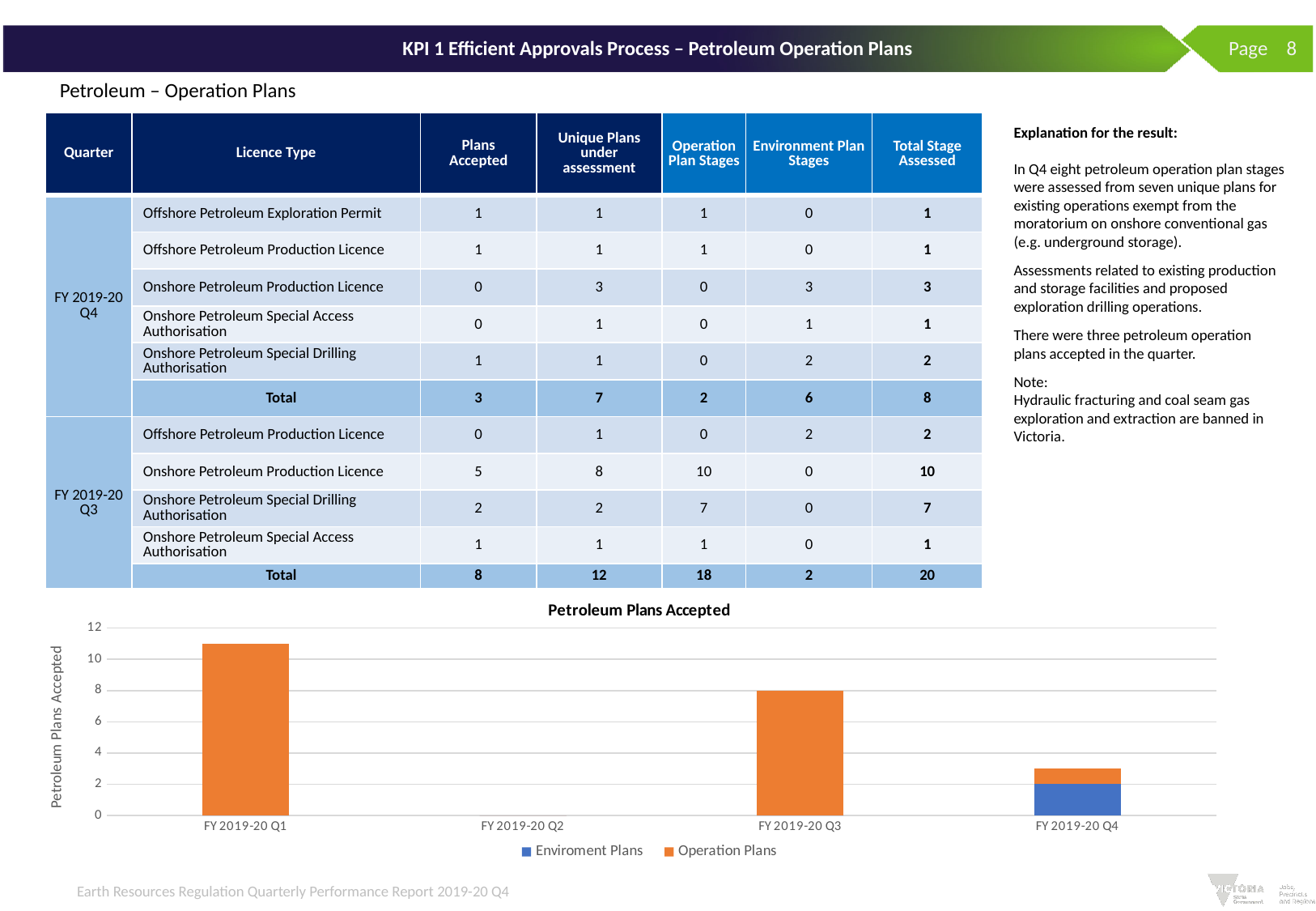
In the 'Petroleum Plans Accepted' chart, which quarter has the highest bar? FY 2019-20 Q1 In the 'Petroleum Plans Accepted' chart, which quarter has the lowest total of plans accepted? FY 2019-20 Q2 How many series does the legend of the 'Petroleum Plans Accepted' chart list? 2 In the 'Petroleum Plans Accepted' chart, what colour represents Operation Plans? orange In the 'Petroleum Plans Accepted' chart, what is the value of Operation Plans for FY 2019-20 Q3? 8 What kind of chart is the 'Petroleum Plans Accepted' chart? bar chart In the 'Petroleum Plans Accepted' chart, which is larger: the bar for FY 2019-20 Q1 or the bar for FY 2019-20 Q3? FY 2019-20 Q1 In the 'Petroleum Plans Accepted' chart, what is the value of Enviroment Plans for FY 2019-20 Q4? 2 In the 'Petroleum Plans Accepted' chart, which quarter is the only one showing an Enviroment Plans segment? FY 2019-20 Q4 In the 'Petroleum Plans Accepted' chart, is the value for FY 2019-20 Q1 greater or less than 10? greater In the 'Petroleum Plans Accepted' chart, is the total bar height for FY 2019-20 Q4 greater or less than 4? less How many quarters are shown on the x axis of the 'Petroleum Plans Accepted' chart? 4